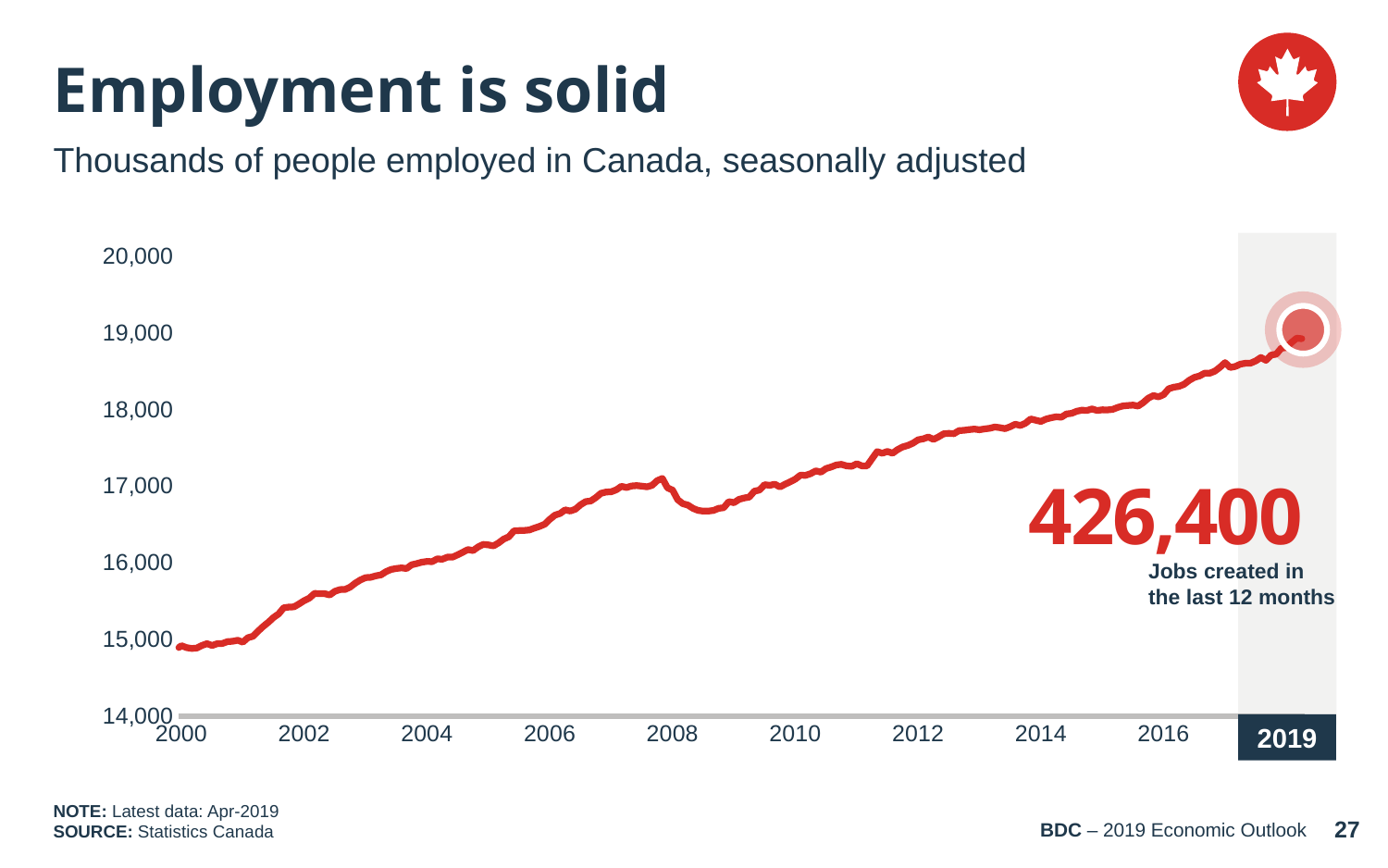
What is the title of the slide? Employment is solid Is the value for 2012 greater or less than 17,000? greater How many jobs does the chart say were created in the last 12 months? 426,400 What kind of chart is shown on the slide? Line chart Is the value for 2019 greater or less than 18,000? greater Is the value for 2006 greater or less than 16,000? greater Overall, does employment rise or fall from 2000 to 2019? Rise What is the source of the data shown in the chart? Statistics Canada Which is larger, the value for 2019 or the value for 2008? 2019